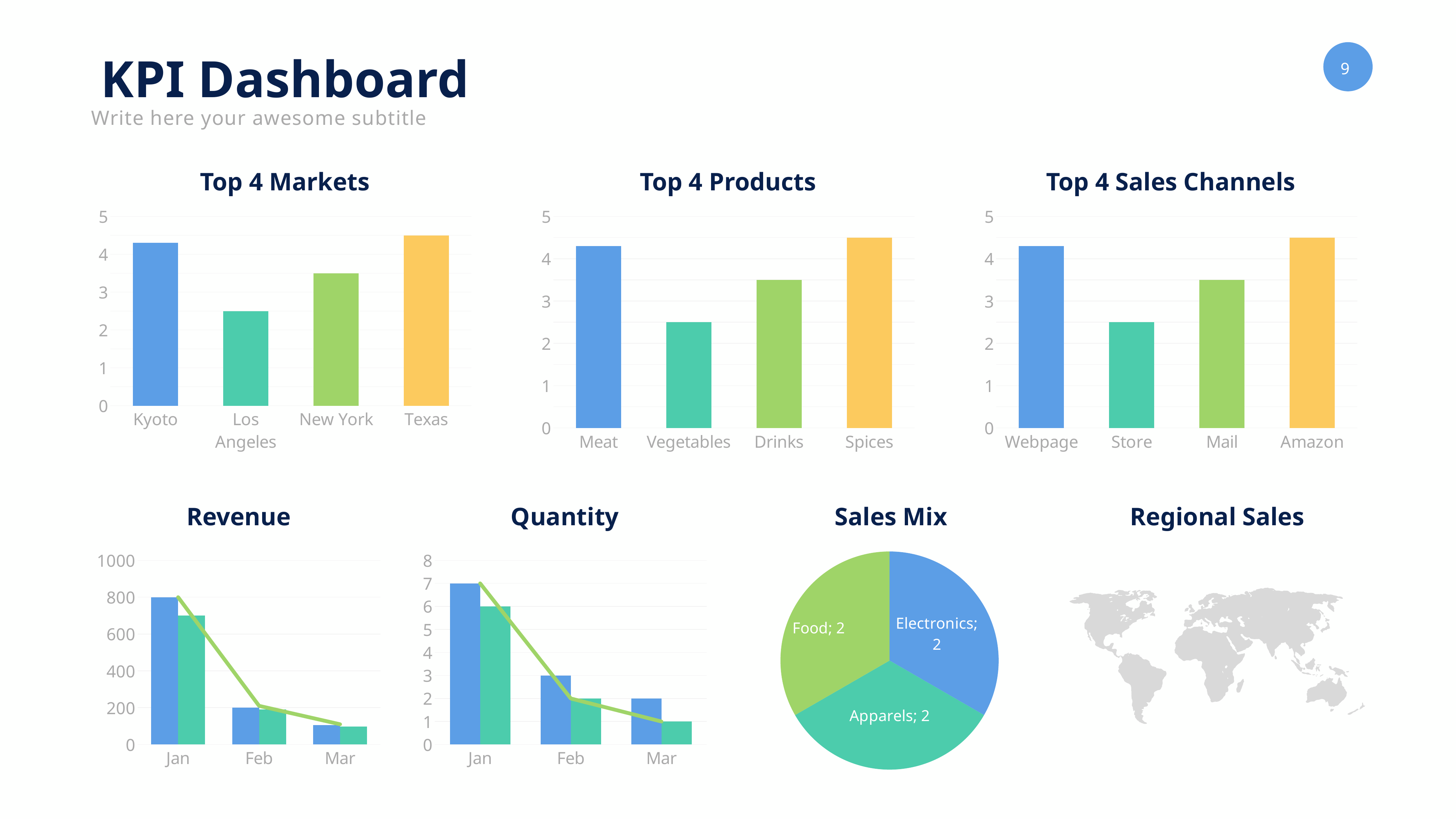
What kind of chart is the Sales Mix chart? pie chart In the Revenue chart, do the values rise or fall from Jan to Mar? fall In the Top 4 Markets chart, is the value for New York greater or less than 3? greater In the Top 4 Products chart, which product has the lowest value? Vegetables In the Top 4 Products chart, is the value for Meat greater or less than 4? greater In the Top 4 Markets chart, which market has the highest bar? Texas In the Quantity chart, what is the value of the blue bar for Jan? 7 In the Top 4 Markets chart, which market has the lowest bar? Los Angeles In the Quantity chart, what is the value of the teal bar for Mar? 1 In the Sales Mix chart, what is the value shown for Apparels? 2 In the Top 4 Sales Channels chart, how many sales channels are shown? 4 In the Top 4 Sales Channels chart, which is larger, Store or Mail? Mail